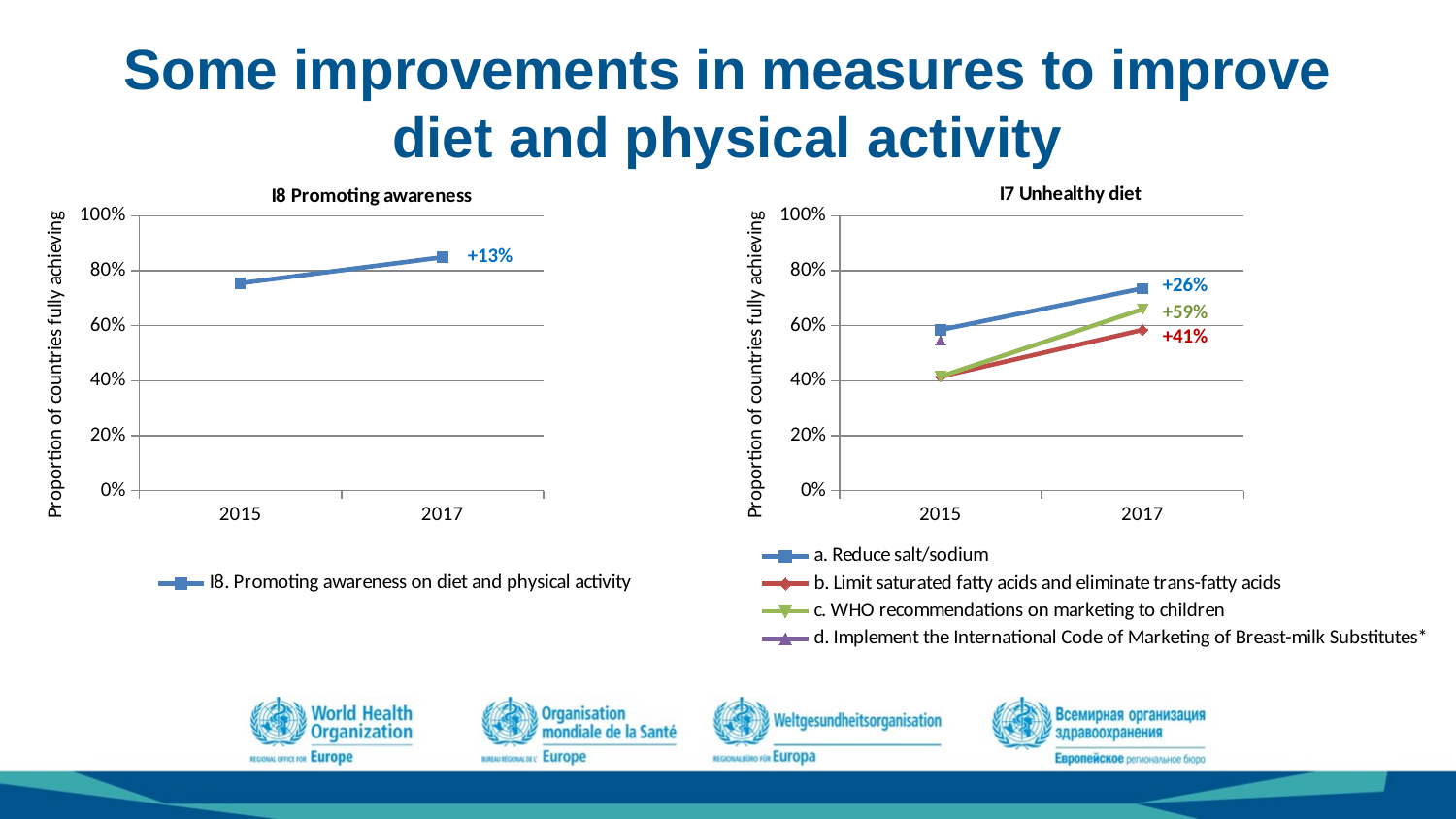
In the 'I7 Unhealthy diet' chart, which is larger in 2017: the value for 'a. Reduce salt/sodium' or for 'b. Limit saturated fatty acids and eliminate trans-fatty acids'? a. Reduce salt/sodium In the 'I8 Promoting awareness' chart, is the 2015 value greater or less than 60%? greater In the 'I7 Unhealthy diet' chart, what percentage change is labelled for 'b. Limit saturated fatty acids and eliminate trans-fatty acids'? +41% In the 'I7 Unhealthy diet' chart, what percentage change is labelled for 'c. WHO recommendations on marketing to children'? +59% How many years are shown on the x axis of the 'I8 Promoting awareness' chart? 2 In the 'I8 Promoting awareness' chart, does the value rise or fall from 2015 to 2017? rise How many series does the legend of the 'I7 Unhealthy diet' chart list? 4 What percentage change is labelled on the line in the 'I8 Promoting awareness' chart? +13% What kind of chart is the 'I8 Promoting awareness' chart? line chart In the 'I7 Unhealthy diet' chart, what percentage change is labelled for 'a. Reduce salt/sodium'? +26% In the 'I7 Unhealthy diet' chart, which series has the highest value in 2017? a. Reduce salt/sodium In the 'I7 Unhealthy diet' chart, is the 2017 value for 'a. Reduce salt/sodium' greater or less than 60%? greater